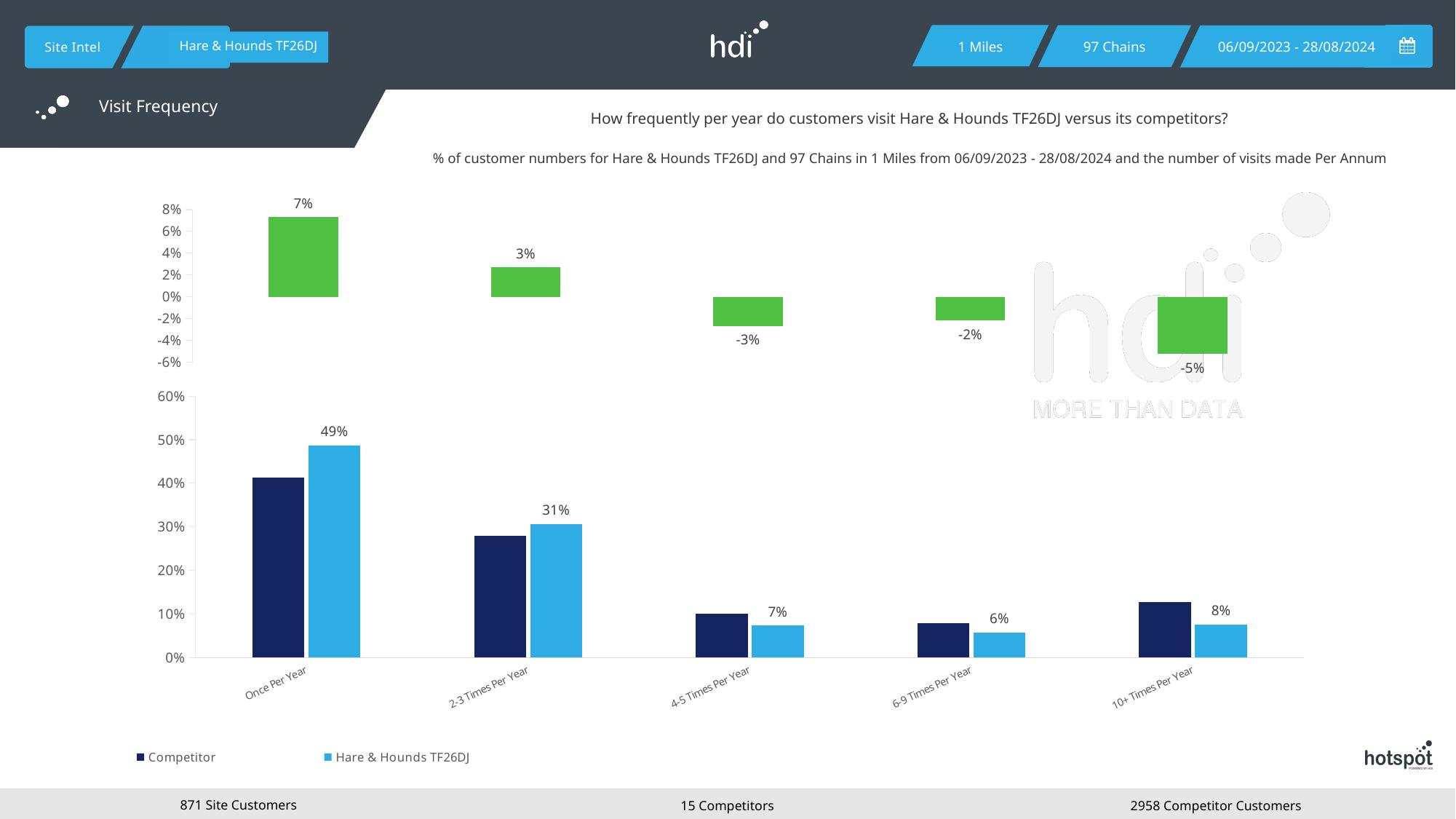
What kind of chart is the bottom chart? Bar chart In the bottom chart, which category has the highest value for Hare & Hounds TF26DJ? Once Per Year How many series does the legend of the bottom chart list? 2 In the bottom chart, what is the value for Hare & Hounds TF26DJ for 10+ Times Per Year? 8% In the bottom chart, what is the difference between the Hare & Hounds TF26DJ values for Once Per Year and 2-3 Times Per Year? 18% In the bottom chart, which category has the lowest value for Hare & Hounds TF26DJ? 6-9 Times Per Year In the top chart, what is the value shown for 10+ Times Per Year? -5% In the bottom chart, is the Competitor value for Once Per Year greater or less than 30%? greater In the bottom chart, what is the value for Hare & Hounds TF26DJ for Once Per Year? 49% In the top chart, what is the value shown for Once Per Year? 7% In the bottom chart, which is larger for 10+ Times Per Year: Competitor or Hare & Hounds TF26DJ? Competitor In the bottom chart, what is the value for Hare & Hounds TF26DJ for 2-3 Times Per Year? 31%